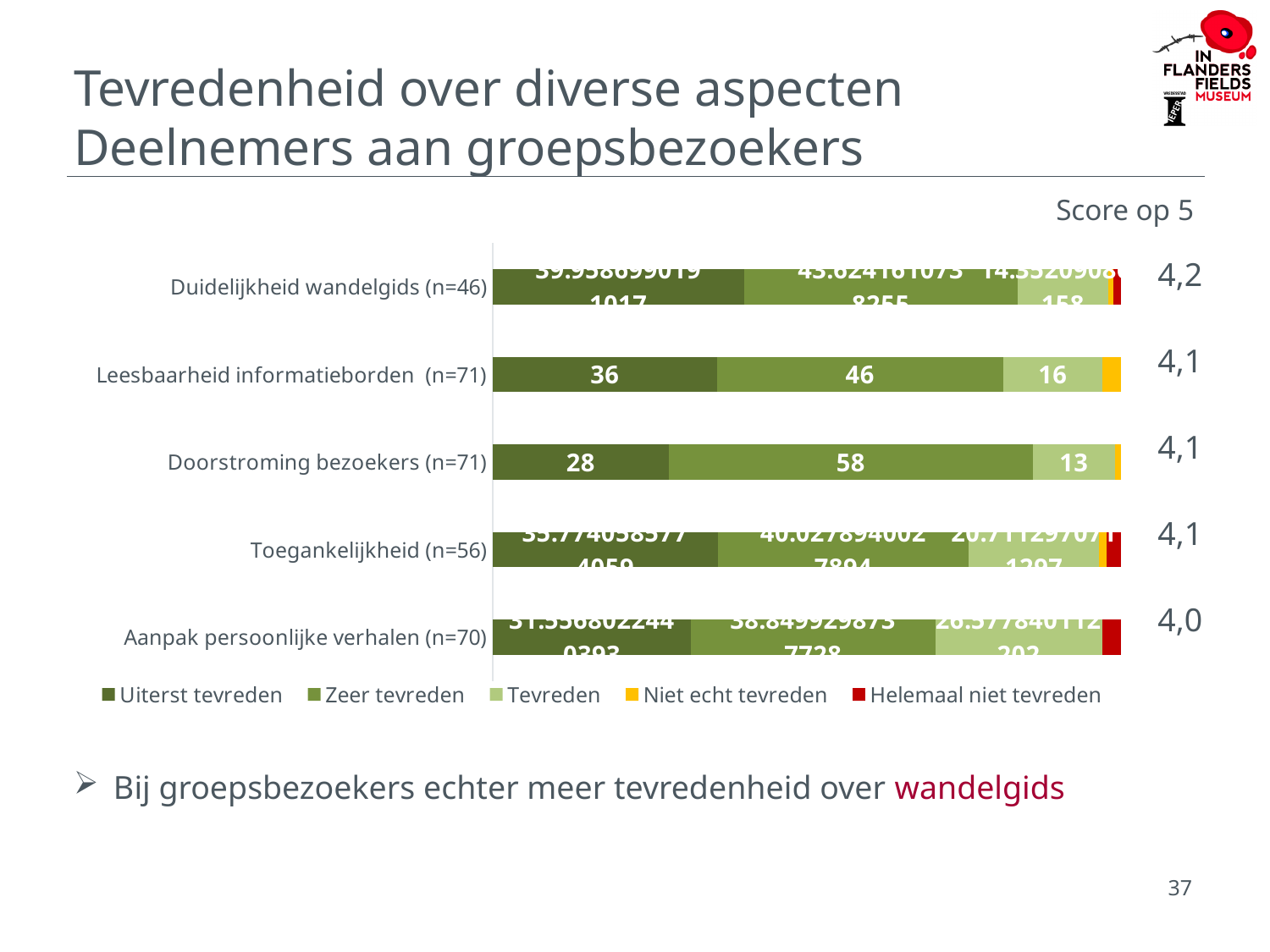
What is the 'Zeer tevreden' value for Doorstroming bezoekers (n=71)? 58 Which aspect has the lowest score on 5? Aanpak persoonlijke verhalen (n=70) What kind of chart is shown on the slide? Stacked bar chart What is the 'Tevreden' value for Leesbaarheid informatieborden (n=71)? 16 How many categories (aspects) are shown on the chart? 5 What is the 'Uiterst tevreden' value for Doorstroming bezoekers (n=71)? 28 What is the 'Uiterst tevreden' value for Leesbaarheid informatieborden (n=71)? 36 Which aspect has the highest score on 5? Duidelijkheid wandelgids (n=46) What is the difference between the 'Zeer tevreden' values for Doorstroming bezoekers (n=71) and Leesbaarheid informatieborden (n=71)? 12 How many series does the legend list? 5 What is the score on 5 shown for Duidelijkheid wandelgids (n=46)? 4,2 Which is larger: the 'Uiterst tevreden' value for Leesbaarheid informatieborden (n=71) or for Doorstroming bezoekers (n=71)? Leesbaarheid informatieborden (n=71)